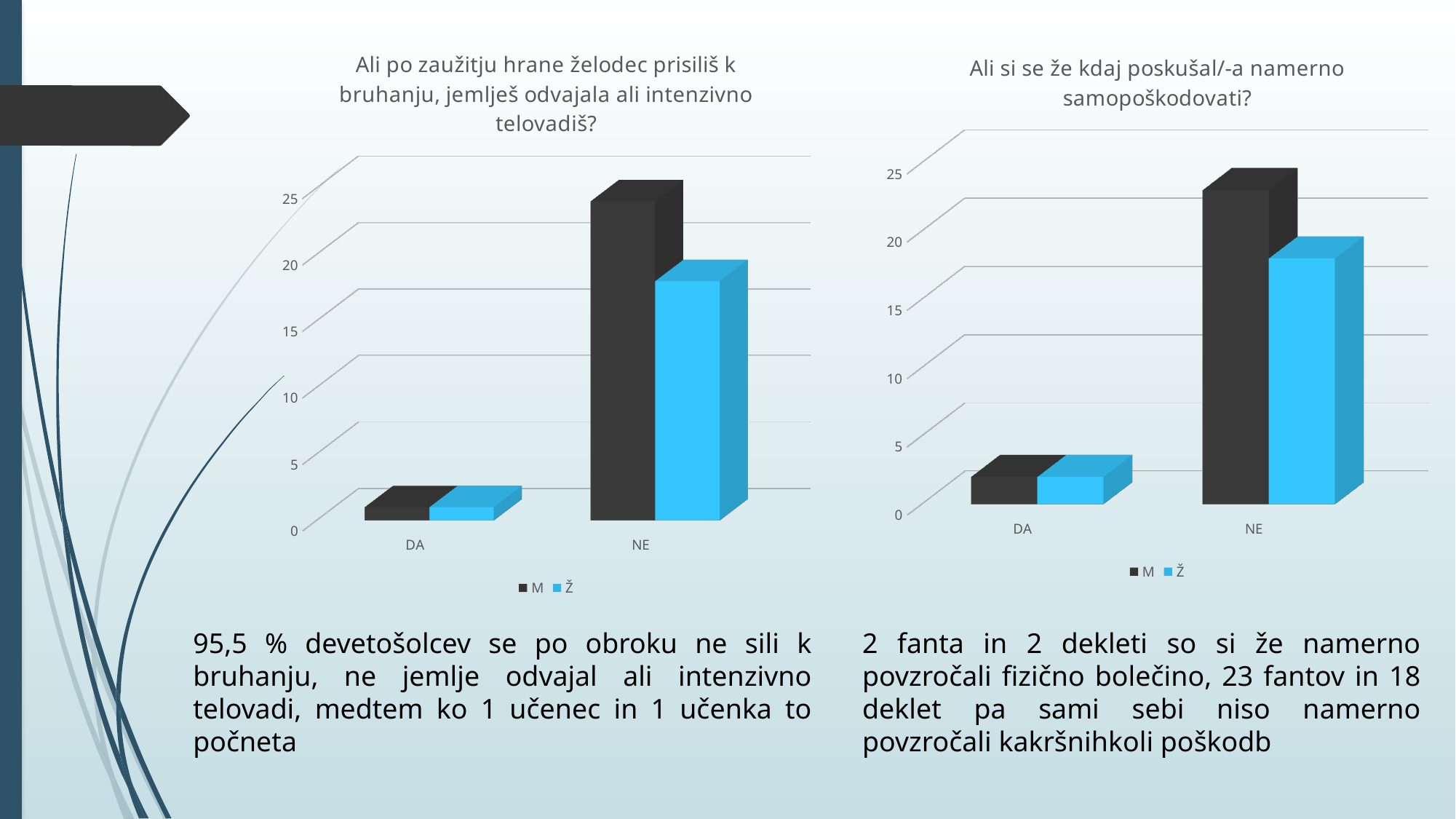
What kind of chart is the left chart titled "Ali po zaužitju hrane želodec prisiliš k bruhanju, jemlješ odvajala ali intenzivno telovadiš?"? Bar chart In the right chart, which is larger in category NE: M or Ž? M What are the two legend entries of the left chart? M and Ž How many series does the legend of the right chart "Ali si se že kdaj poskušal/-a namerno samopoškodovati?" list? 2 In the right chart, what is the value for Ž in category NE, as stated in the text below the chart? 18 In the left chart, how many categories are shown on the x axis? 2 In the right chart, which category has the lowest value for series Ž? DA In the left chart, is the value for Ž in category DA greater or less than 5? less In the right chart, is the value for Ž in category NE greater or less than 15? greater In the left chart, is the value for M in category NE greater or less than 20? greater In the left chart, which category has the highest value for series M? NE In the right chart, what is the value for M in category NE, as stated in the text below the chart? 23